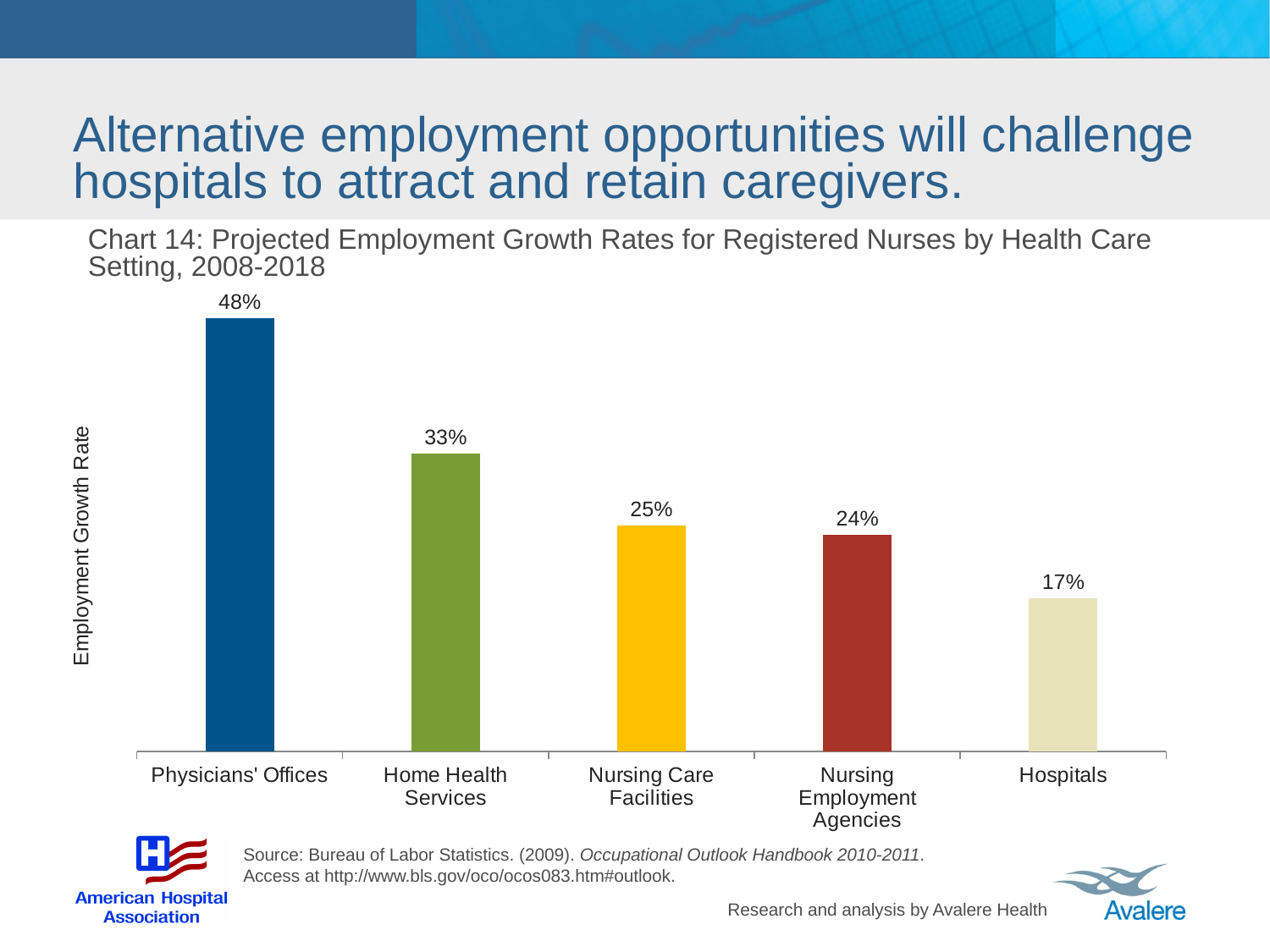
What type of chart is shown on the slide? Bar chart What is the difference in projected growth rate between Home Health Services and Nursing Care Facilities? 8% How many health care settings are shown in the chart? 5 What is the projected employment growth rate for Physicians' Offices? 48% What is the projected employment growth rate for Nursing Employment Agencies? 24% Which has a higher projected growth rate, Nursing Care Facilities or Hospitals? Nursing Care Facilities Do the values rise or fall from left to right across the chart? Fall Which health care setting has the lowest projected employment growth rate? Hospitals What is the projected employment growth rate for Home Health Services? 33% What is the difference in projected growth rate between Physicians' Offices and Hospitals? 31% What is the projected employment growth rate for Hospitals? 17% Which health care setting has the highest projected employment growth rate? Physicians' Offices